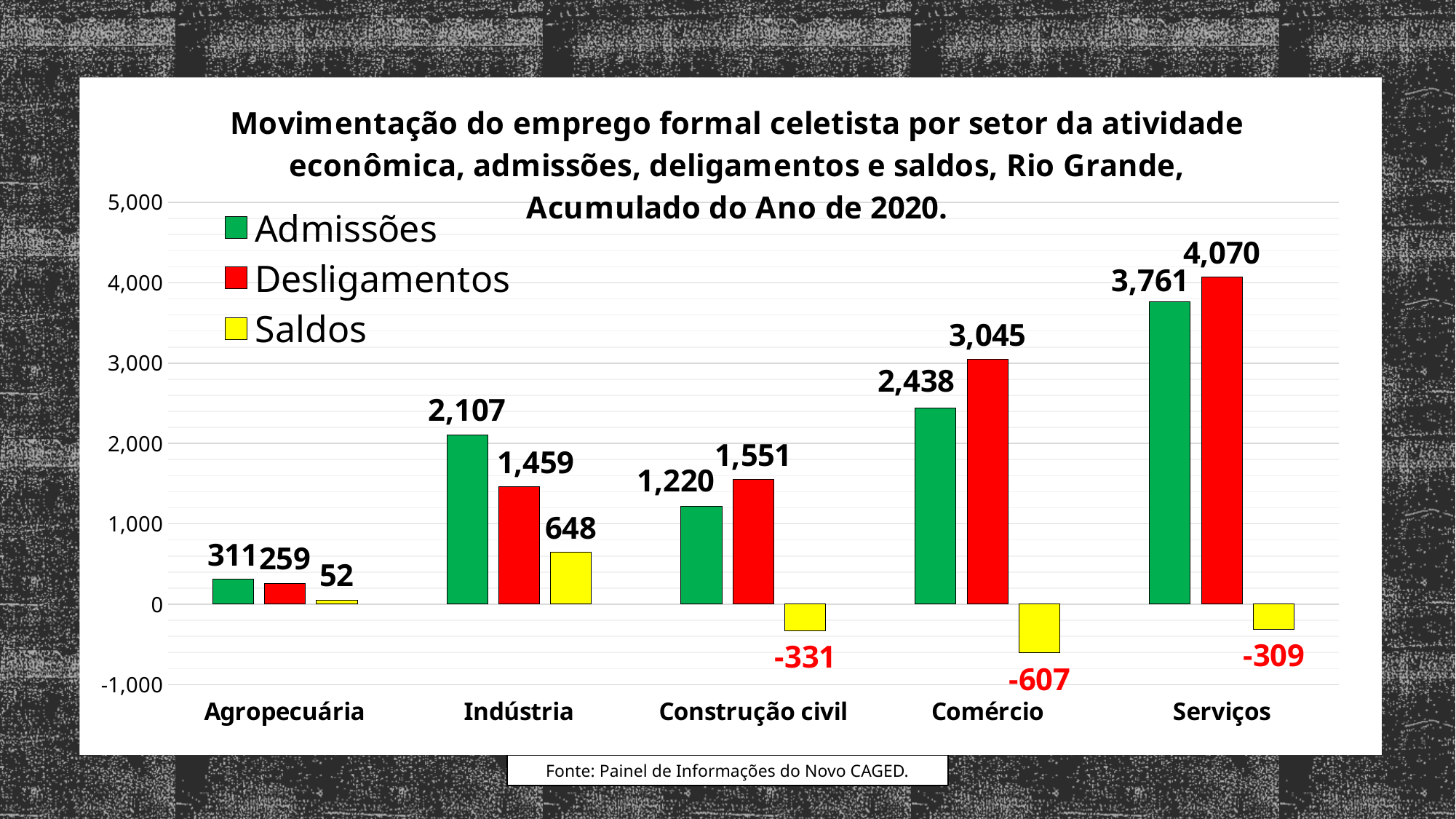
What is the Desligamentos value for Serviços? 4,070 What is the Saldos value for Comércio? -607 How many series does the legend list? 3 Which sector has the lowest Desligamentos value? Agropecuária Which sector has the highest Admissões value? Serviços Which is larger for Construção civil, Admissões or Desligamentos? Desligamentos Which sector has the highest Saldos value? Indústria What is the Admissões value for Indústria? 2,107 What colour represents the Saldos series in the legend? Yellow What kind of chart is shown on the slide? Bar chart How many sectors are shown on the x axis? 5 What is the difference between Desligamentos and Admissões for Comércio? 607